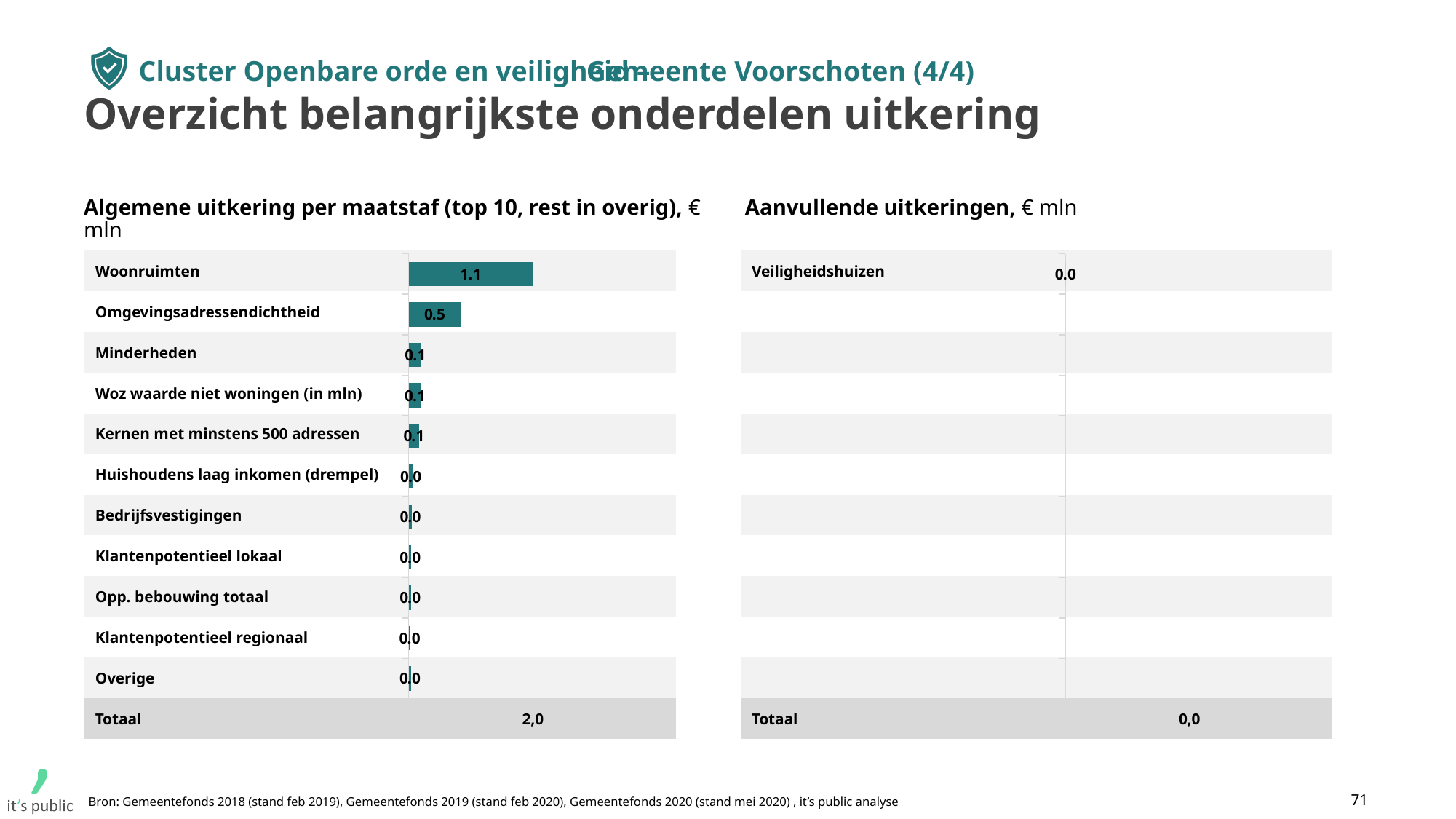
In the chart 'Algemene uitkering per maatstaf', which category has the highest value? Woonruimten How many categories (excluding the Totaal row) are shown in the chart 'Algemene uitkering per maatstaf'? 11 What is the Totaal shown for the chart 'Algemene uitkering per maatstaf'? 2,0 In the chart 'Aanvullende uitkeringen', what is the value for Veiligheidshuizen? 0.0 In the chart 'Algemene uitkering per maatstaf', which is larger: Omgevingsadressendichtheid or Kernen met minstens 500 adressen? Omgevingsadressendichtheid What is the Totaal shown for the chart 'Aanvullende uitkeringen'? 0,0 In the chart 'Algemene uitkering per maatstaf', what is the difference between Woonruimten and Omgevingsadressendichtheid? 0.6 In the chart 'Algemene uitkering per maatstaf', what is the value for Omgevingsadressendichtheid? 0.5 What type of chart is 'Algemene uitkering per maatstaf'? Bar chart In what unit are the values in the chart 'Aanvullende uitkeringen' expressed, according to its title? € mln In the chart 'Algemene uitkering per maatstaf', what is the value for Minderheden? 0.1 In the chart 'Algemene uitkering per maatstaf', what is the value for Woonruimten? 1.1